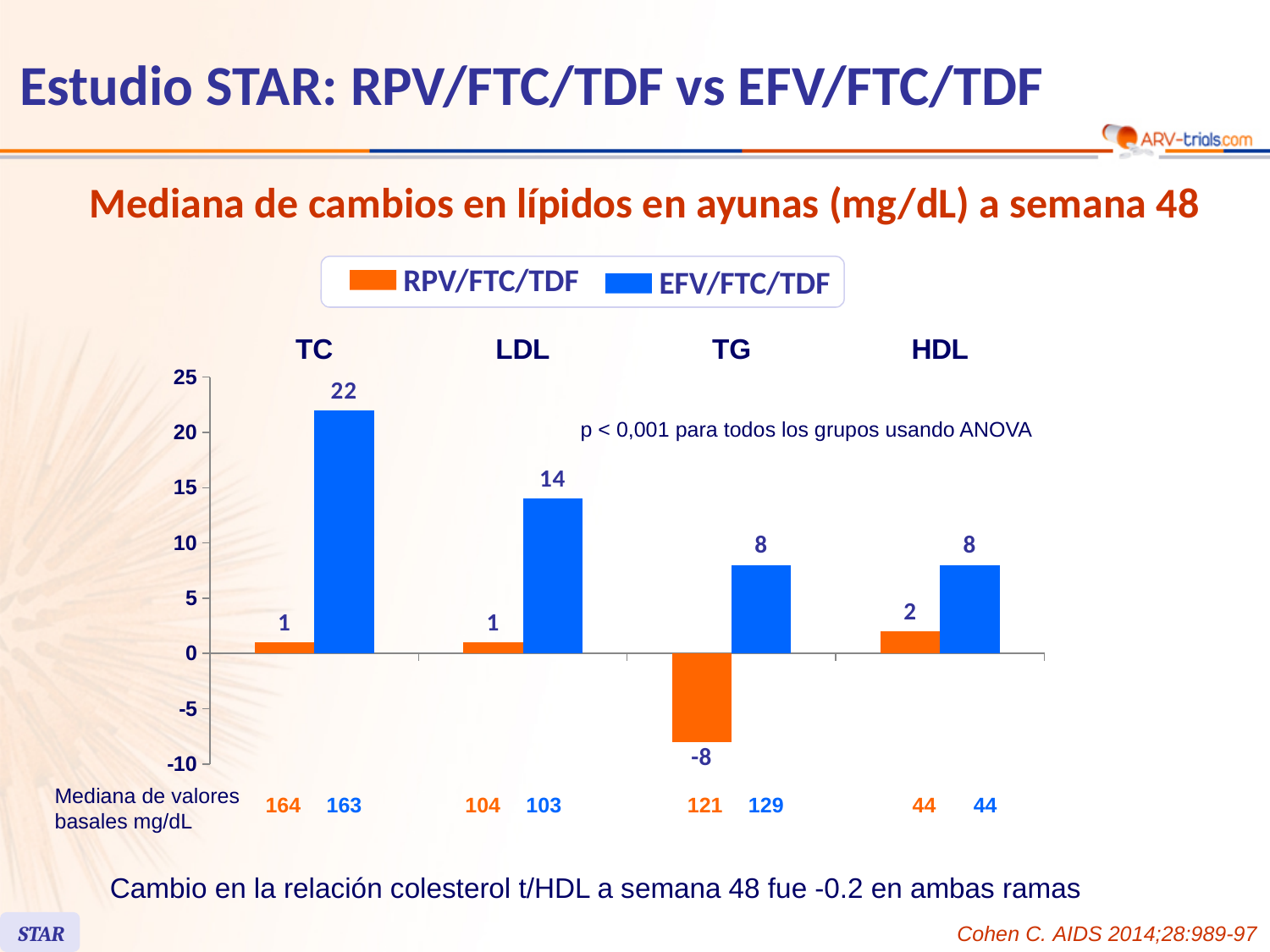
Which arm has the larger median change in LDL, RPV/FTC/TDF or EFV/FTC/TDF? EFV/FTC/TDF How many series does the legend list? 2 What is the difference between the EFV/FTC/TDF and RPV/FTC/TDF median changes in TC? 21 What kind of chart is shown on the slide? Bar chart What is the median change in LDL for the EFV/FTC/TDF arm? 14 Which lipid parameter shows the highest median change for the EFV/FTC/TDF arm? TC What is the median change in HDL for the RPV/FTC/TDF arm? 2 Which lipid parameter shows the lowest median change for the RPV/FTC/TDF arm? TG What is the difference between the EFV/FTC/TDF and RPV/FTC/TDF median changes in TG? 16 What is the median change in TG for the RPV/FTC/TDF arm? -8 What is the median change in TC for the EFV/FTC/TDF arm? 22 How many lipid parameters are shown on the x axis of the chart? 4